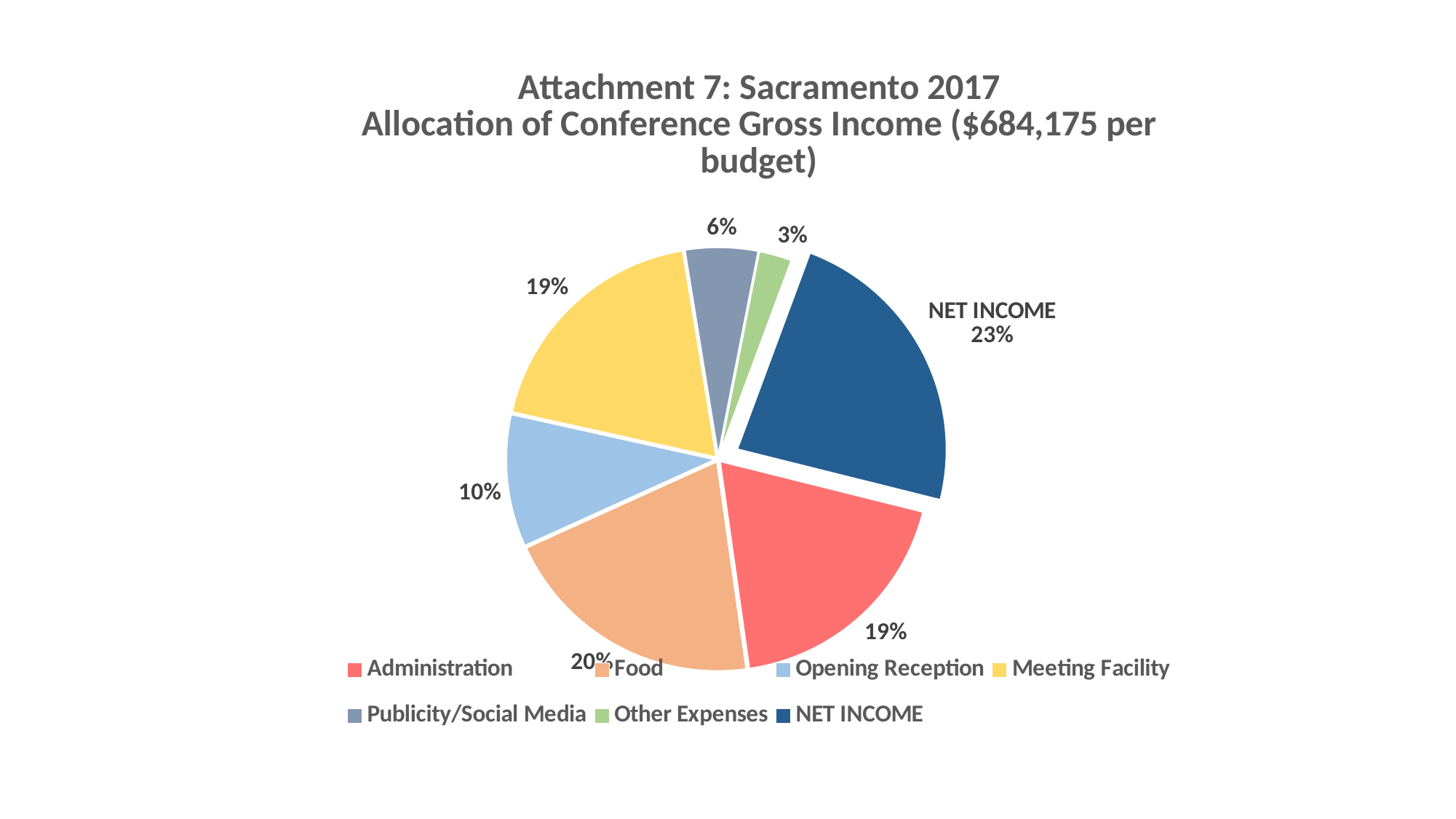
Which category has the smallest slice of the pie? Other Expenses What total gross income amount is stated in the chart title? $684,175 Which is larger, the share for Food or the share for Opening Reception? Food How many categories does the pie chart show? 7 Which category has the largest slice of the pie? NET INCOME What is the difference in percentage points between NET INCOME and Food? 3 What percentage is allocated to Other Expenses? 3% What percentage is allocated to Opening Reception? 10% What percentage is allocated to Publicity/Social Media? 6% What percentage of the pie is Food? 20% What type of chart is shown on the slide? Pie chart What share of conference gross income is NET INCOME? 23%